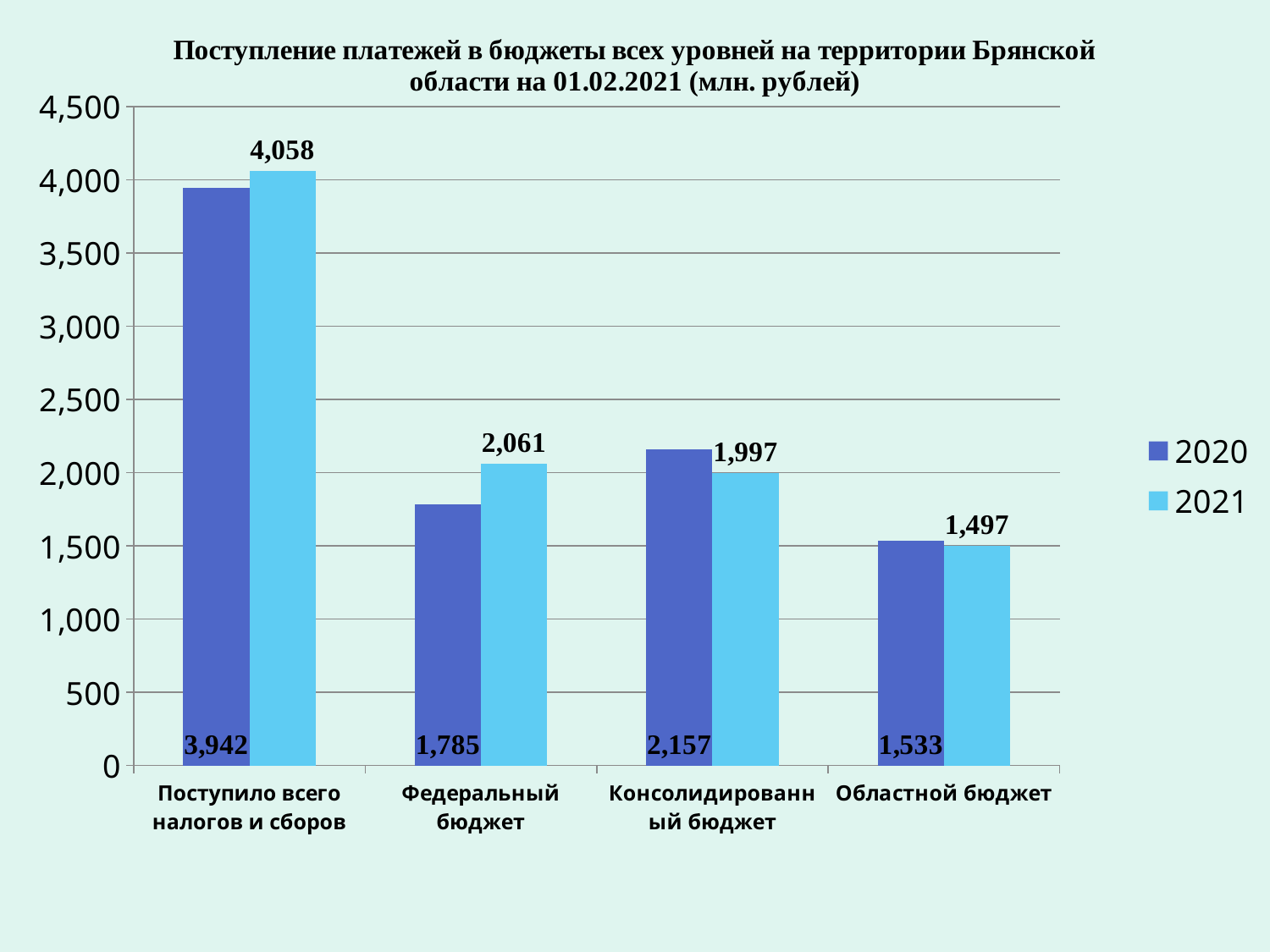
Which category has the highest 2020 value? Поступило всего налогов и сборов What kind of chart is shown on the slide? Bar chart What is the 2020 value for Федеральный бюджет? 1,785 How many series does the legend list? 2 Which category has the lowest 2021 value? Областной бюджет For Федеральный бюджет, which year has the larger value, 2020 or 2021? 2021 What is the 2021 value for Поступило всего налогов и сборов? 4,058 How many categories are shown on the x axis? 4 What is the difference between the 2021 and 2020 values for Поступило всего налогов и сборов? 116 What is the 2021 value for Консолидированный бюджет? 1,997 What is the difference between the 2020 and 2021 values for Консолидированный бюджет? 160 What is the 2020 value for Областной бюджет? 1,533